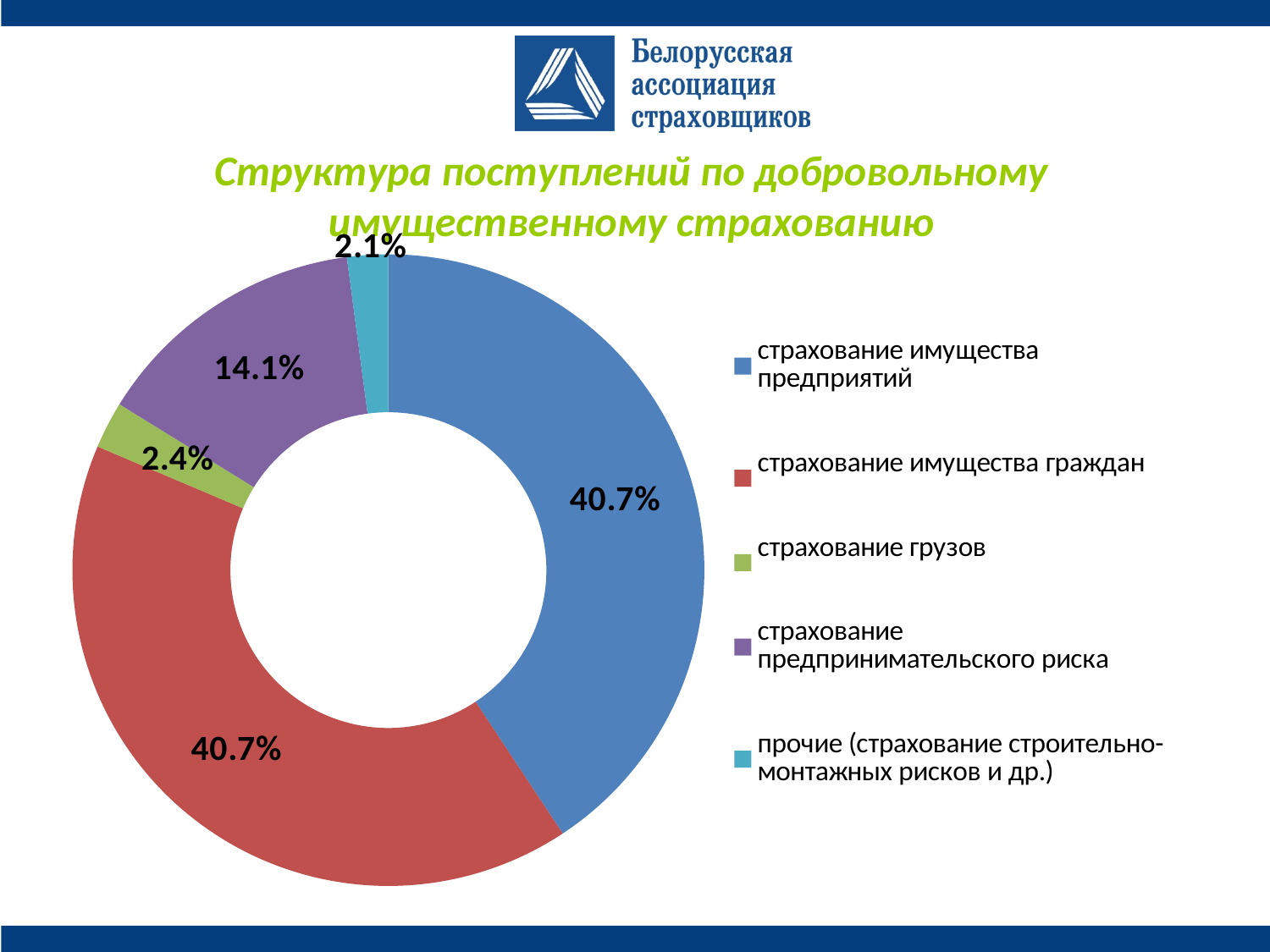
How many categories are shown in the chart? 5 Which is larger: the share of страхование предпринимательского риска or the share of страхование грузов? страхование предпринимательского риска Which category has the smallest share of the pie? прочие (страхование строительно-монтажных рисков и др.) What share of the pie does страхование грузов have? 2.4% What share of the pie does страхование предпринимательского риска have? 14.1% What is the difference between the shares of страхование предпринимательского риска and страхование грузов? 11.7% What share of the pie does прочие (страхование строительно-монтажных рисков и др.) have? 2.1% What is the title of the chart? Структура поступлений по добровольному имущественному страхованию What share of the pie does страхование имущества предприятий have? 40.7% What colour is the slice for страхование имущества граждан? red What kind of chart is shown on the slide? doughnut chart What share of the pie does страхование имущества граждан have? 40.7%